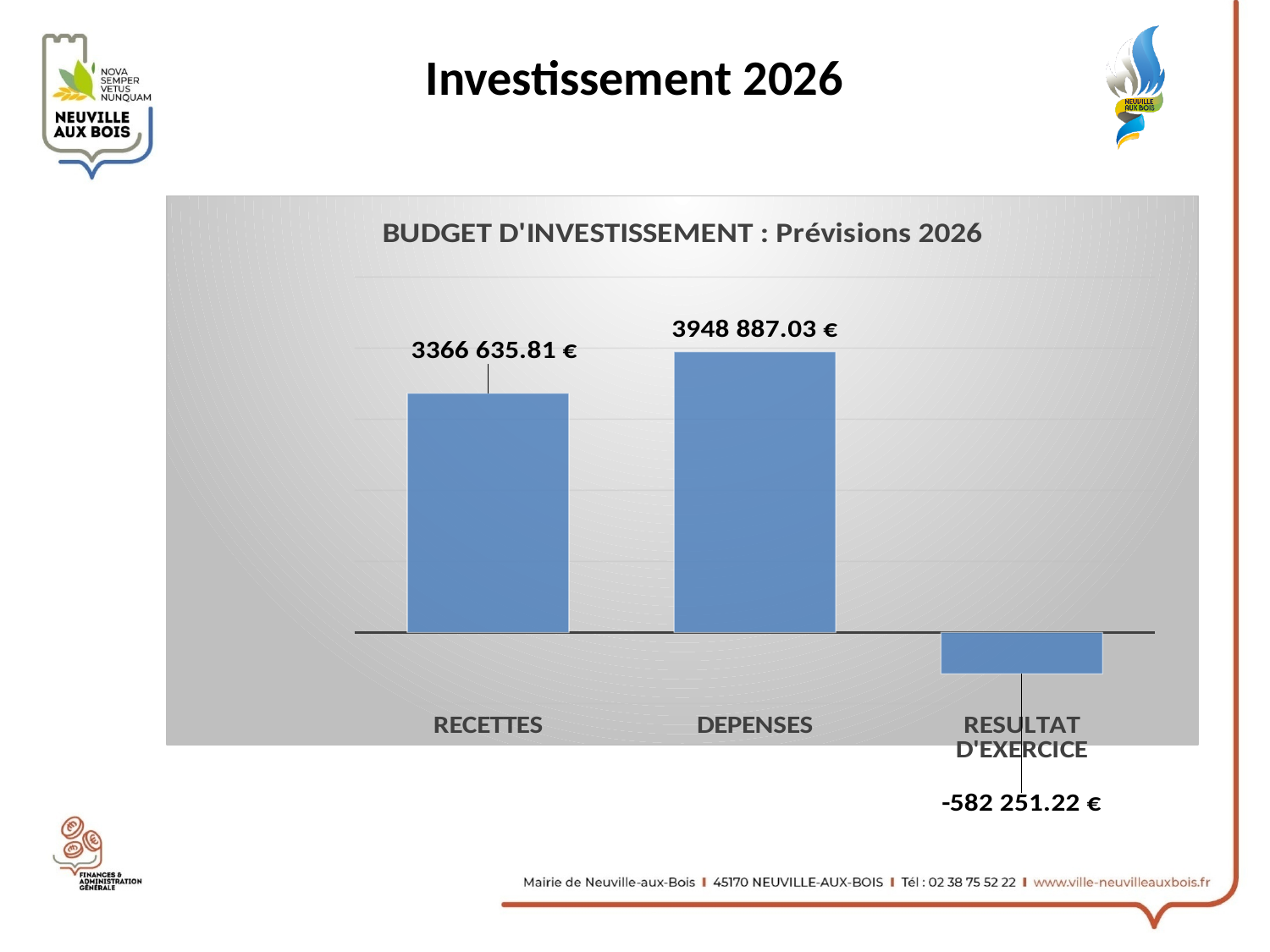
What is the value for RESULTAT D'EXERCICE in the chart? -582 251.22 € What is the value for RECETTES in the chart? 3366 635.81 € Which is larger, RECETTES or DEPENSES? DEPENSES What is the difference between DEPENSES and RECETTES? 582 251.22 € Which category has the lowest value in the chart? RESULTAT D'EXERCICE Which category has the highest value in the chart? DEPENSES What is the value for DEPENSES in the chart? 3948 887.03 € What is the title of the chart? BUDGET D'INVESTISSEMENT : Prévisions 2026 Which category has a negative value in the chart? RESULTAT D'EXERCICE What kind of chart is shown on the slide? Bar chart How many categories are shown in the chart? 3